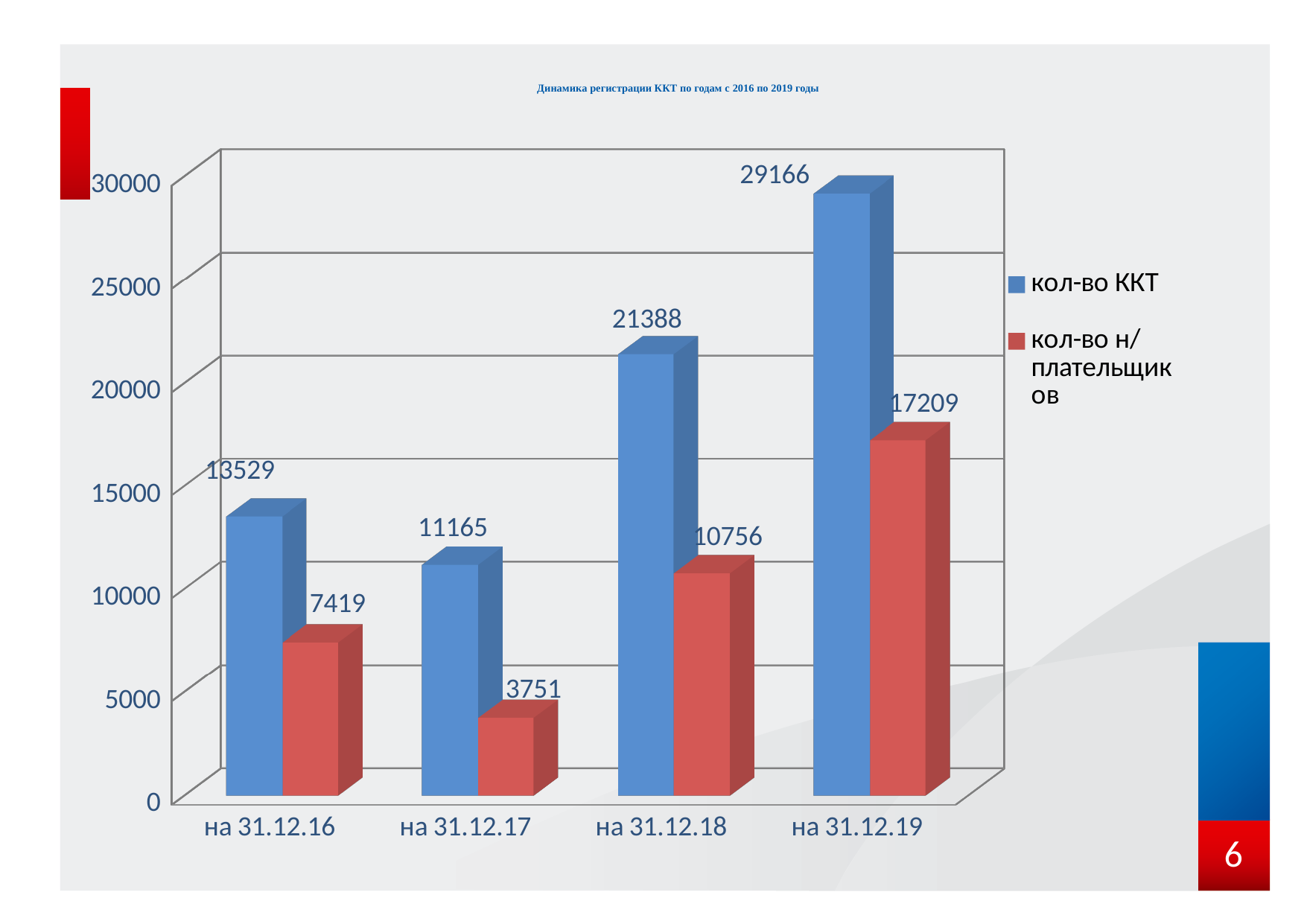
What is the value of кол-во н/плательщиков for на 31.12.18? 10756 What is the value of кол-во ККТ for на 31.12.19? 29166 What kind of chart is shown on the slide? bar chart What is the title of the chart? Динамика регистрации ККТ по годам с 2016 по 2019 годы What is the difference between кол-во ККТ and кол-во н/плательщиков for на 31.12.19? 11957 Which category has the lowest value for кол-во н/плательщиков? на 31.12.17 How many categories are shown on the x axis? 4 What is the value of кол-во н/плательщиков for на 31.12.17? 3751 What is the value of кол-во ККТ for на 31.12.16? 13529 How many series does the legend list? 2 Which is larger: кол-во ККТ for на 31.12.17 or кол-во н/плательщиков for на 31.12.19? кол-во н/плательщиков for на 31.12.19 Which category has the highest value for кол-во ККТ? на 31.12.19